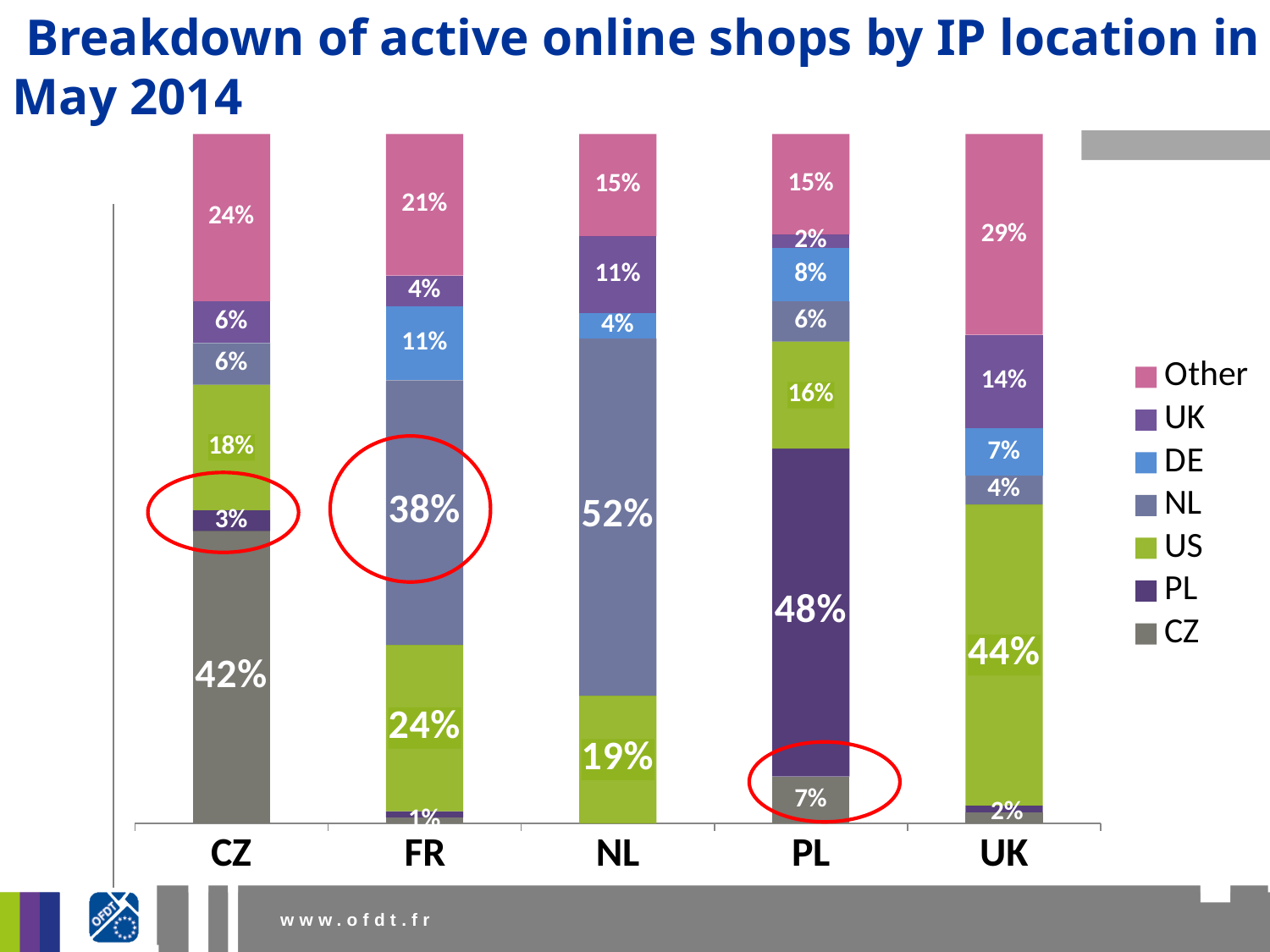
Which country bar has the smallest US segment? PL In the PL bar, what is the value of the PL segment? 48% What percentage of active online shops in the NL bar are located at NL IP addresses (the NL segment of the NL bar)? 52% What is the value of the US segment in the UK bar? 44% What is the value of the DE segment in the FR bar? 11% How many country bars are shown on the x axis? 5 What is the value of the CZ segment in the CZ bar? 42% What kind of chart is shown on the slide? Stacked bar chart Which is larger: the US segment in the FR bar or the US segment in the NL bar? FR Which country bar has the largest 'Other' segment? UK How many percentage points larger is the NL segment in the NL bar than the NL segment in the FR bar? 14 percentage points How many series does the legend list? 7